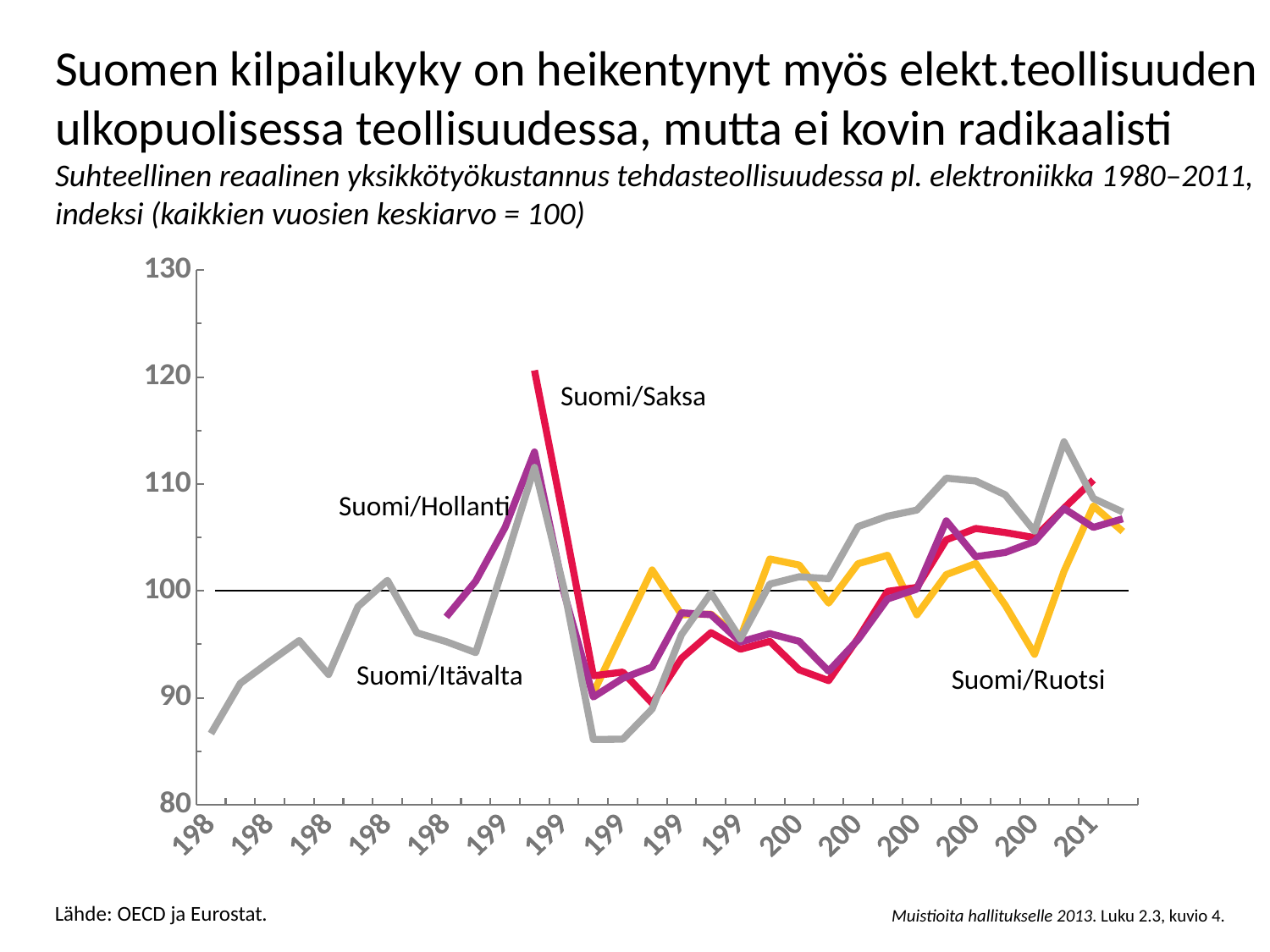
Does the Suomi/Itävalta series rise or fall between its first and last plotted points? rise What is the highest value shown on the vertical axis? 130 Is the highest point of the Suomi/Itävalta series greater or less than 110? greater How many series are plotted on the chart? 4 Is the lowest point of the Suomi/Ruotsi series greater or less than 100? less What value does the horizontal reference line on the chart mark? 100 What kind of chart is shown on the slide? line chart Which series reaches the lowest value anywhere on the chart? Suomi/Itävalta Which series is drawn in yellow? Suomi/Ruotsi Is the first plotted value of the Suomi/Itävalta series (at the left edge of the chart) greater or less than 90? less Which series reaches the highest value anywhere on the chart? Suomi/Saksa